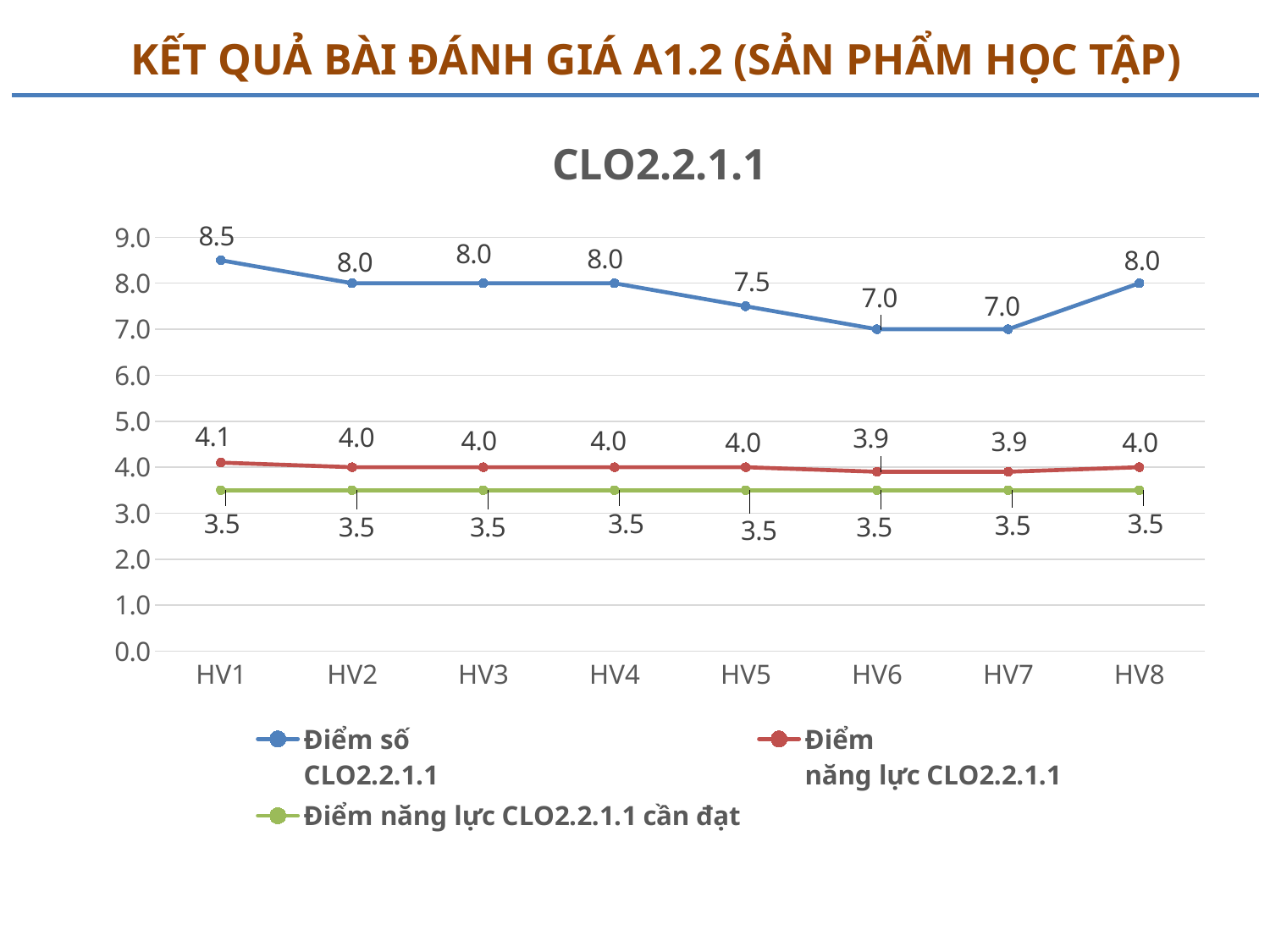
What is the value of Điểm năng lực CLO2.2.1.1 cần đạt for HV4? 3.5 What is the difference between the Điểm số CLO2.2.1.1 values for HV1 and HV6? 1.5 Which category has the highest value for Điểm năng lực CLO2.2.1.1? HV1 What is the value of Điểm số CLO2.2.1.1 for HV1? 8.5 What is the value of Điểm năng lực CLO2.2.1.1 for HV6? 3.9 What kind of chart is shown on the slide? line chart Does the Điểm số CLO2.2.1.1 series rise or fall from HV1 to HV6? fall How many categories are shown on the x axis? 8 How many series does the legend list? 3 What is the title of the chart? CLO2.2.1.1 Which category has the highest value for Điểm số CLO2.2.1.1? HV1 Which is larger: the Điểm số CLO2.2.1.1 value for HV5 or for HV7? HV5